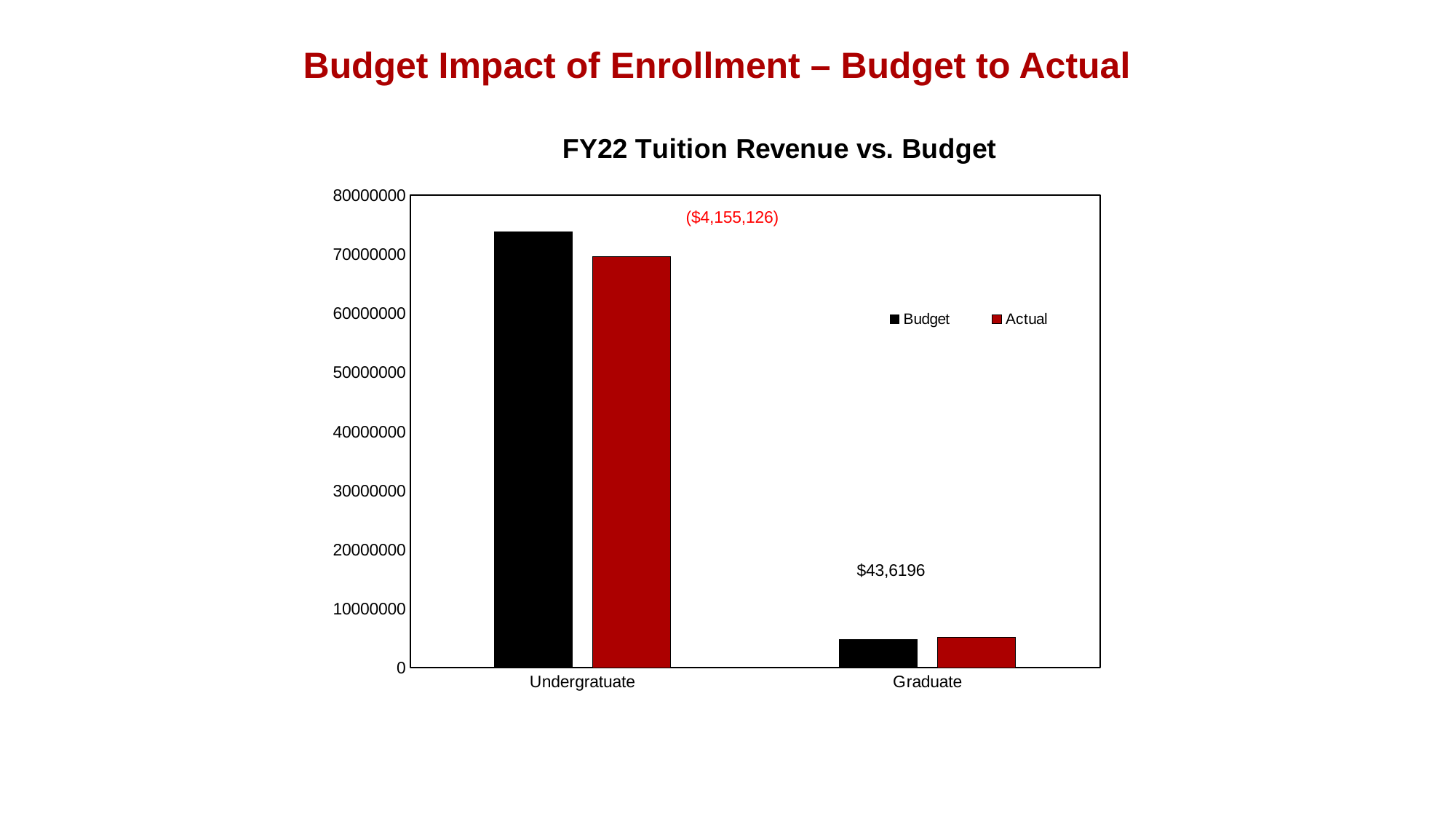
Is the Budget value for Undergratuate greater or less than 70000000? greater What type of chart is shown on the slide? bar chart Is the Actual value for Undergratuate greater or less than 60000000? greater Is the Budget value for Graduate greater or less than 10000000? less Which category has the tallest bar in the chart? Undergratuate For Undergratuate, which is larger, Budget or Actual? Budget What label is printed in red above the Undergratuate bars? ($4,155,126) How many series does the legend list? 2 How many categories are shown on the x axis? 2 What is the title of the chart? FY22 Tuition Revenue vs. Budget What value is printed above the Graduate bars? $43,6196